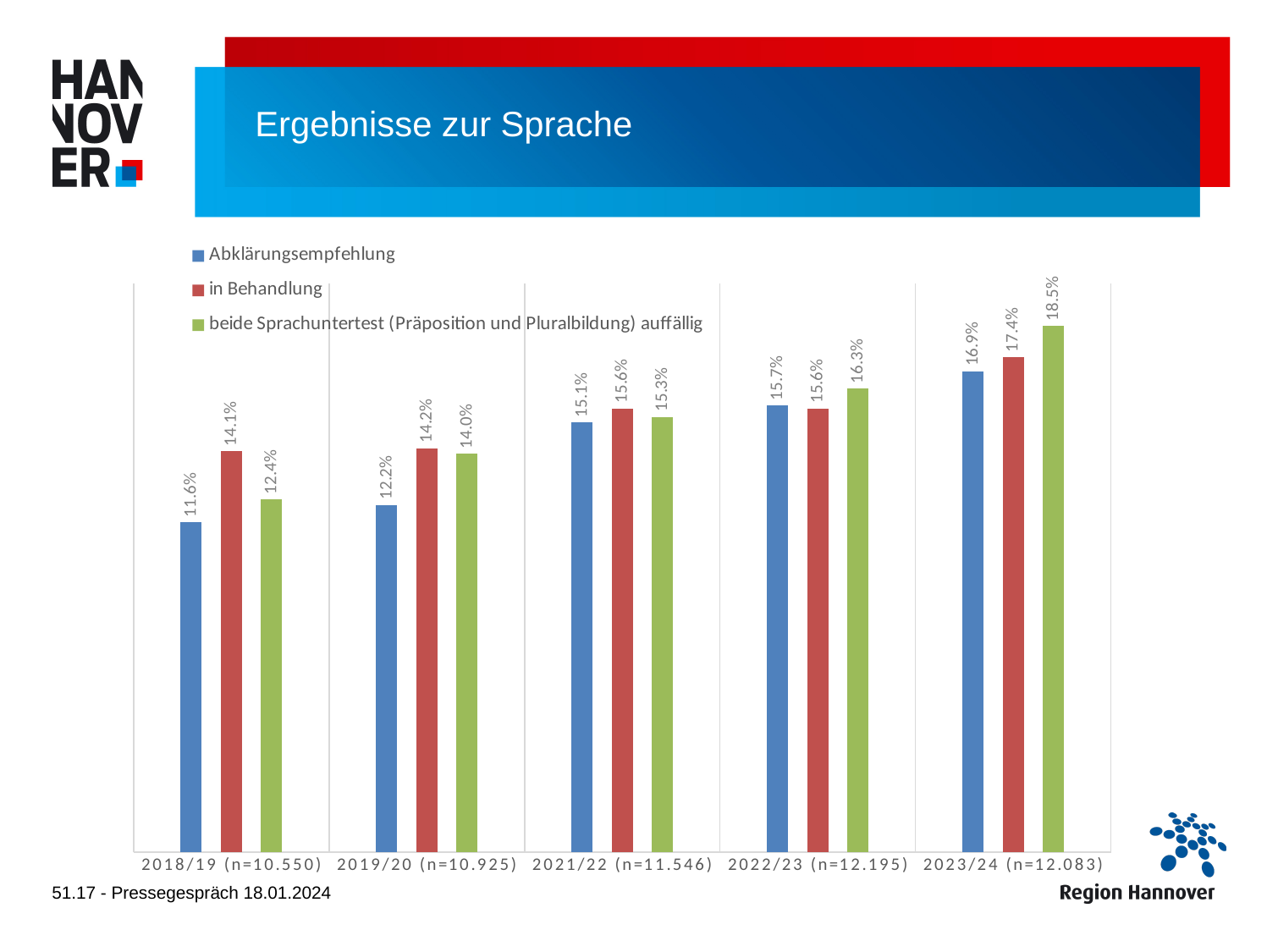
What is the difference between the Abklärungsempfehlung values for 2023/24 (n=12.083) and 2018/19 (n=10.550)? 5.3% Which year has the highest value for beide Sprachuntertest (Präposition und Pluralbildung) auffällig? 2023/24 (n=12.083) What is the value for in Behandlung in 2019/20 (n=10.925)? 14.2% What is the value for beide Sprachuntertest (Präposition und Pluralbildung) auffällig in 2022/23 (n=12.195)? 16.3% Which year has the lowest value for Abklärungsempfehlung? 2018/19 (n=10.550) Do the Abklärungsempfehlung values rise or fall from 2018/19 to 2023/24? rise How many years are shown on the x axis? 5 What is the value for Abklärungsempfehlung in 2018/19 (n=10.550)? 11.6% How many series does the legend list? 3 What kind of chart is shown on the slide? bar chart What is the value for in Behandlung in 2023/24 (n=12.083)? 17.4% Which is larger in 2018/19 (n=10.550): in Behandlung or beide Sprachuntertest (Präposition und Pluralbildung) auffällig? in Behandlung